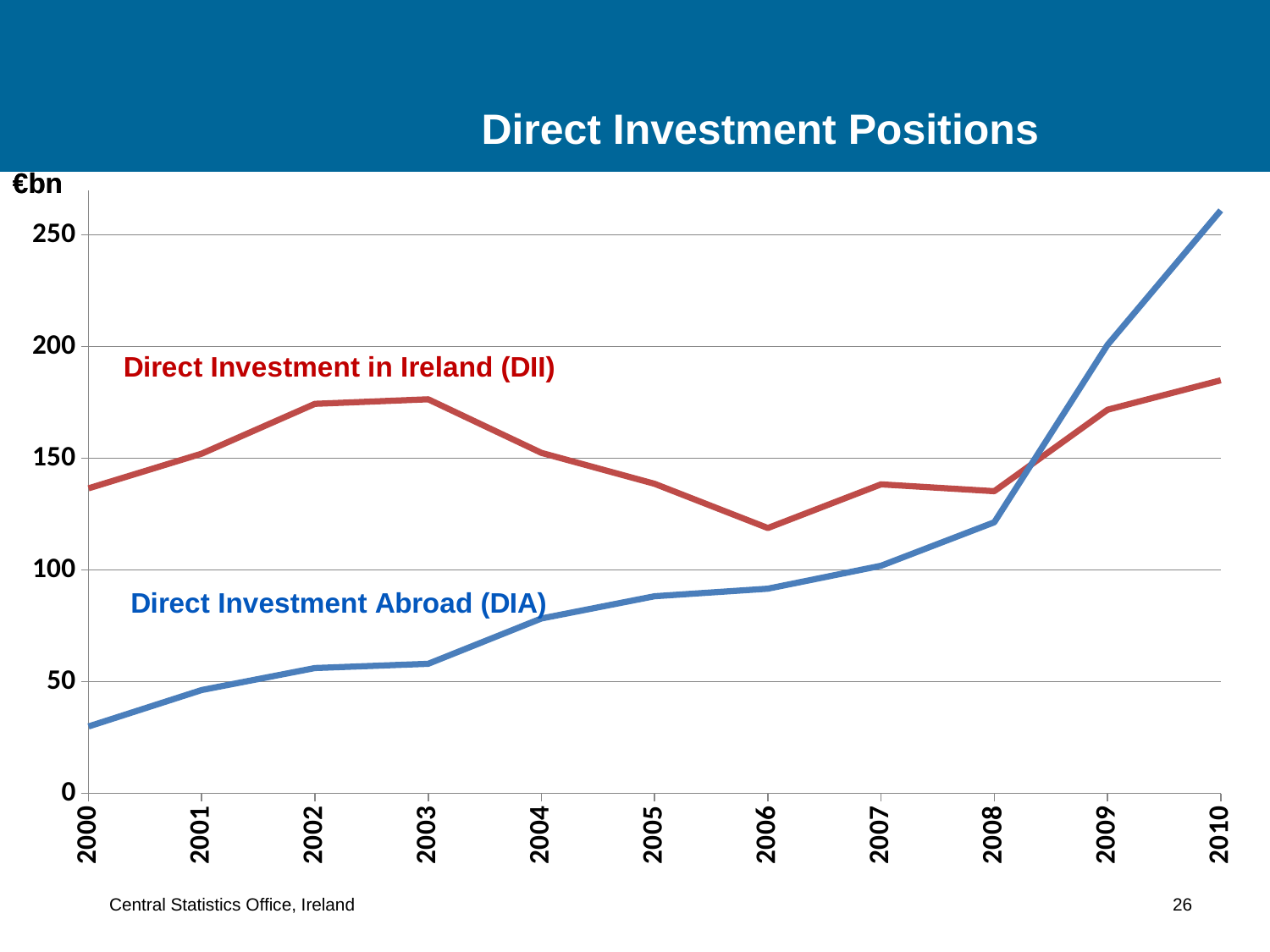
Is the value for Direct Investment Abroad (DIA) in 2010 greater or less than 250? greater How many years are plotted along the x axis? 11 Is the value for Direct Investment in Ireland (DII) in 2002 greater or less than 150? greater In 2000, which series has the larger value, Direct Investment in Ireland (DII) or Direct Investment Abroad (DIA)? Direct Investment in Ireland (DII) Does Direct Investment Abroad (DIA) rise or fall from 2000 to 2010? rise In 2010, which series has the larger value, Direct Investment Abroad (DIA) or Direct Investment in Ireland (DII)? Direct Investment Abroad (DIA) How many series are plotted on the chart? 2 Is the value for Direct Investment Abroad (DIA) in 2000 greater or less than 50? less What kind of chart is shown on the slide? line chart In which year is Direct Investment in Ireland (DII) at its lowest? 2006 In which year does Direct Investment Abroad (DIA) reach its highest value? 2010